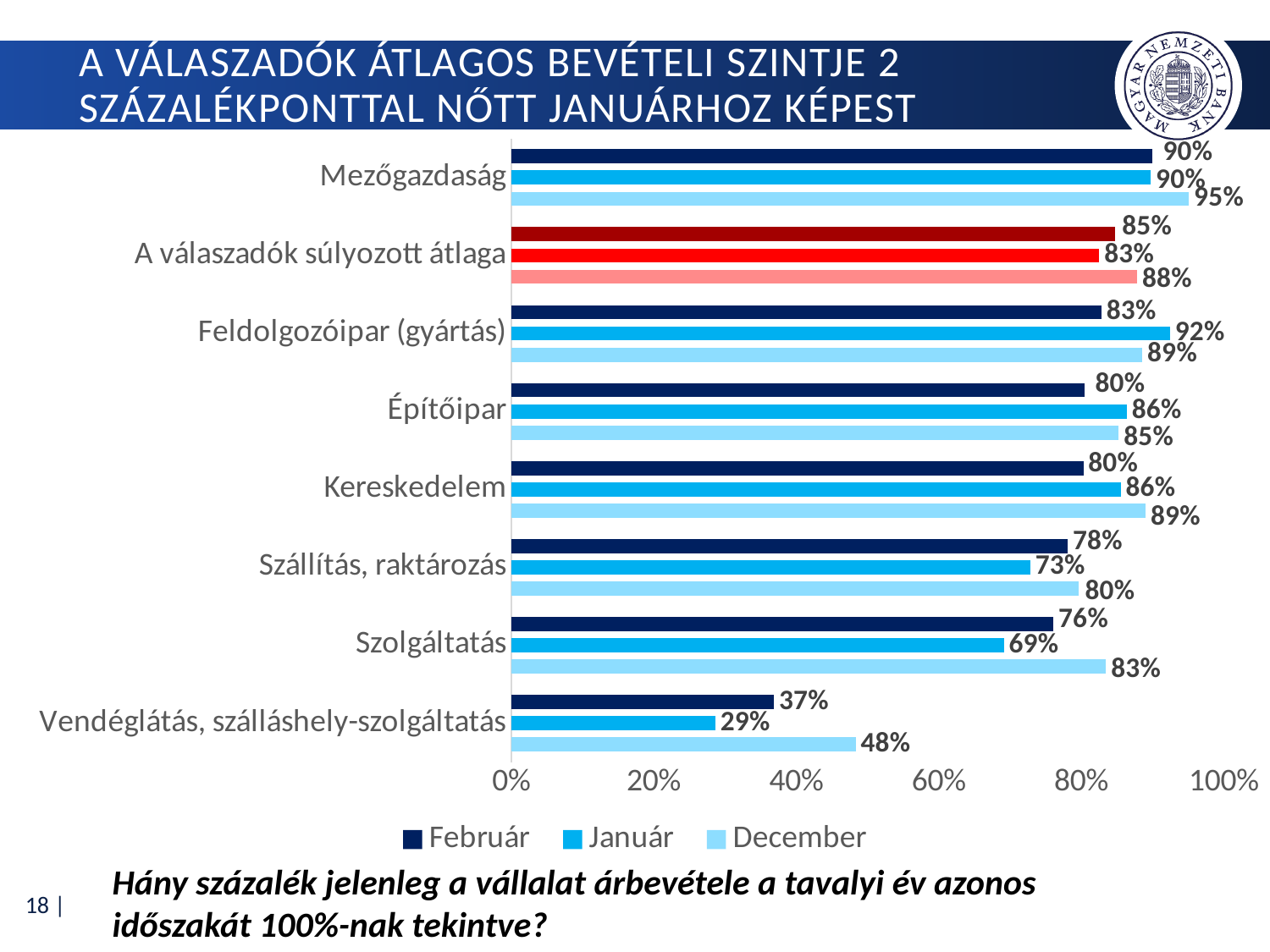
What is the Február value for A válaszadók súlyozott átlaga? 85% How many categories are shown on the chart? 8 Which series is shown in the darkest blue colour in the legend? Február What kind of chart is shown on the slide? Bar chart Which category has the lowest Január value? Vendéglátás, szálláshely-szolgáltatás What is the Január value for Feldolgozóipar (gyártás)? 92% What is the Február value for Mezőgazdaság? 90% How many series does the legend list? 3 Which category has the highest December value? Mezőgazdaság What is the difference between the December and Január values for Szolgáltatás? 14% Which is larger for Szállítás, raktározás: the Február value or the Január value? Február What is the December value for Vendéglátás, szálláshely-szolgáltatás? 48%